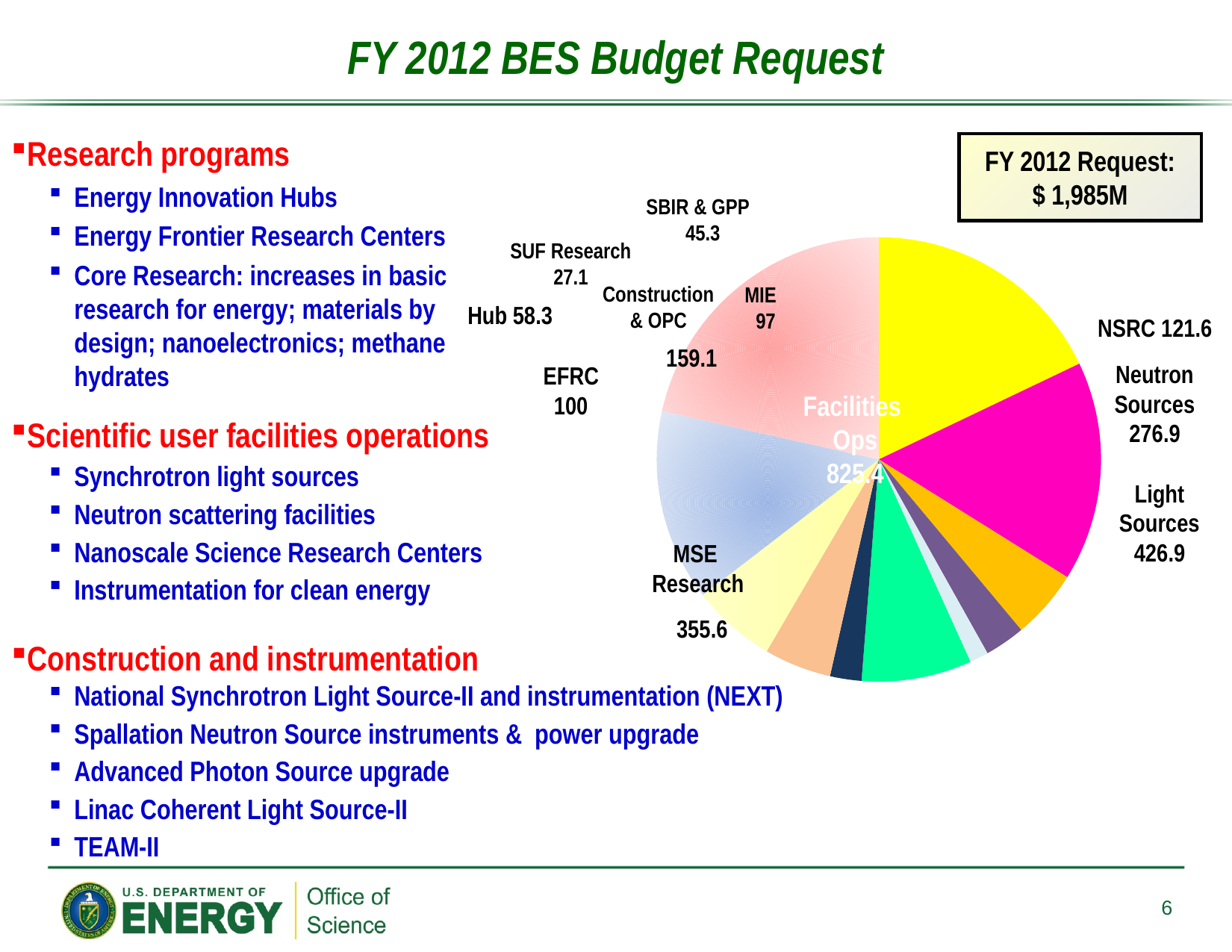
What is the difference between the values for MSE Research and EFRC? 255.6 Which has the larger value, Light Sources or Neutron Sources? Light Sources What is the value shown for SBIR & GPP? 45.3 What is the value shown for Neutron Sources? 276.9 What is the difference between the values for Light Sources and Neutron Sources? 150.0 What is the value shown for MSE Research? 355.6 What is the value shown for EFRC? 100 What total FY 2012 Request amount is shown in the box above the chart? $ 1,985M What is the value shown for Light Sources? 426.9 What is the value shown for NSRC? 121.6 What kind of chart is shown on the slide? pie chart What is the value shown for MIE? 97